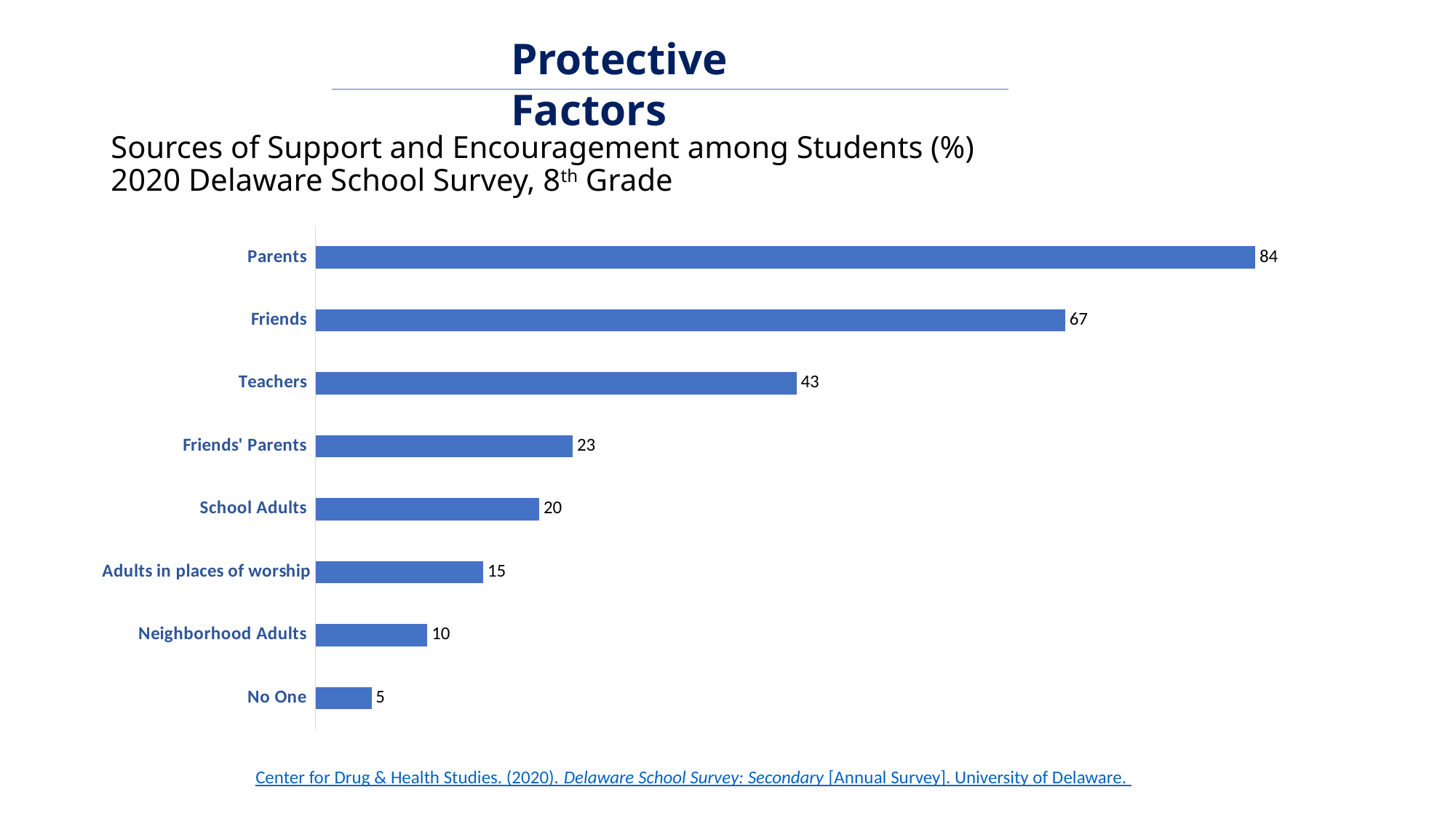
What is the value for Parents? 84 How many categories are shown in the chart? 8 What is the difference between the values for Parents and Friends? 17 Which category has the lowest value? No One What is the value for Adults in places of worship? 15 What kind of chart is shown on the slide? Bar chart What is the difference between the values for Friends' Parents and School Adults? 3 What is the value for Teachers? 43 Which is larger, the value for Neighborhood Adults or the value for Adults in places of worship? Adults in places of worship Which is larger, the value for Teachers or the value for Friends? Friends What is the title of the chart? Sources of Support and Encouragement among Students (%) 2020 Delaware School Survey, 8th Grade Which category has the highest value? Parents